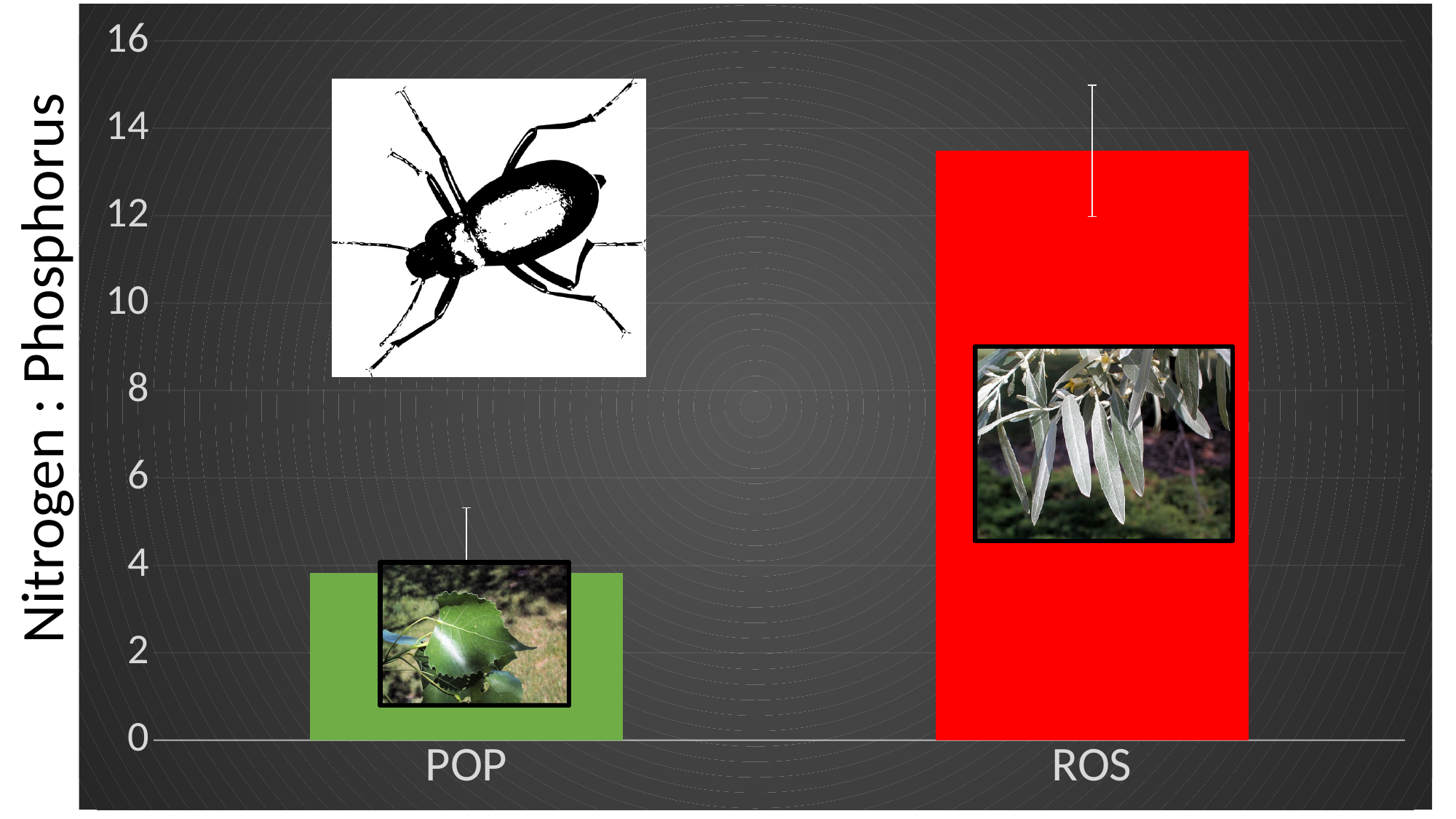
Is the value for ROS greater or less than 12? greater How many categories are shown on the x axis? 2 Which category has the lowest Nitrogen : Phosphorus value? POP What kind of chart is shown on the slide? bar chart Which category has the highest Nitrogen : Phosphorus value? ROS Is the value for ROS greater or less than 14? less Is the value for POP greater or less than 6? less Which is larger, the value for POP or the value for ROS? ROS What colour is the bar for ROS? red What is the title of the y axis? Nitrogen : Phosphorus